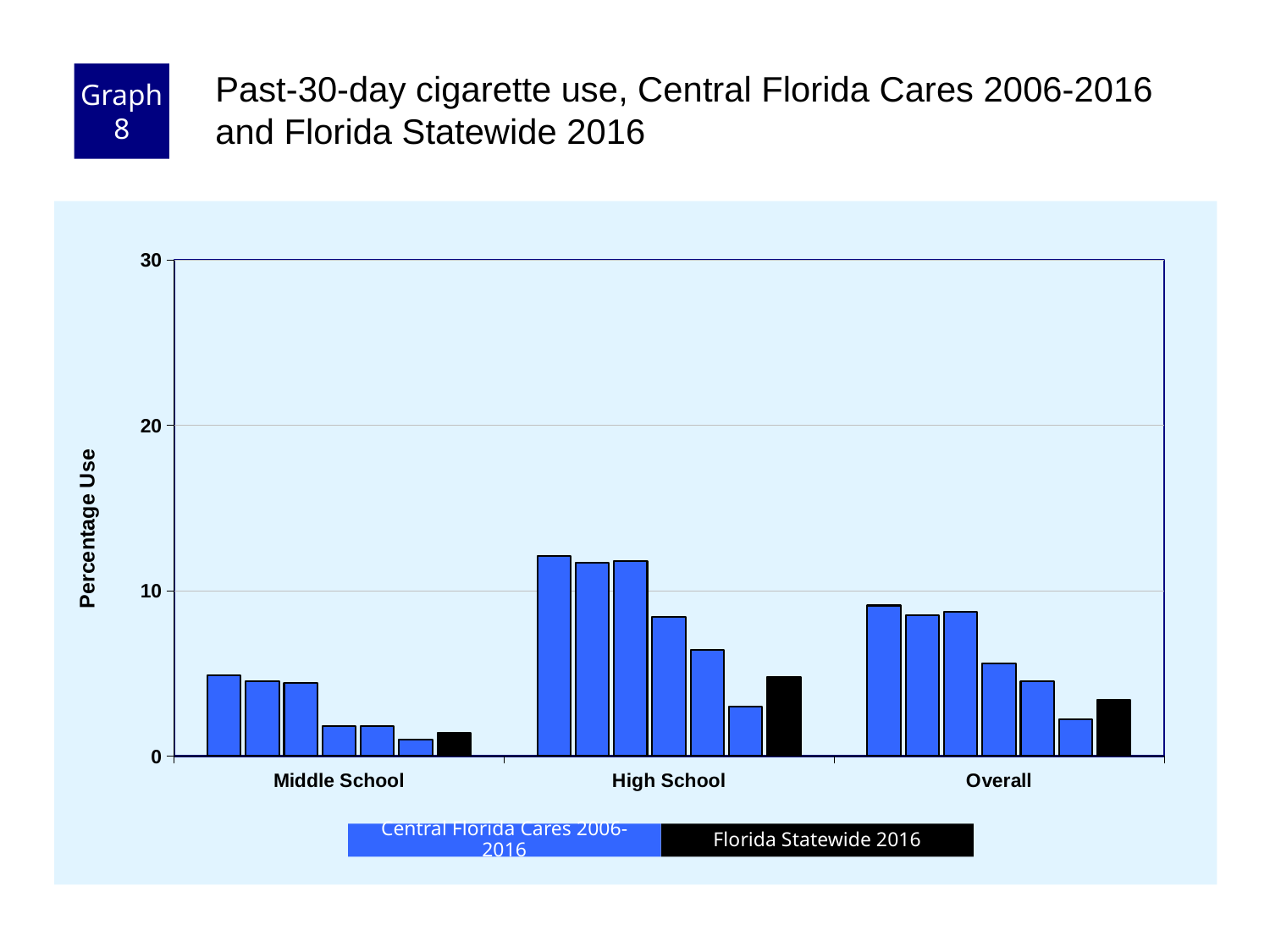
Which is larger, the Florida Statewide 2016 value for High School or for Middle School? High School Which category has the highest bars overall: Middle School, High School, or Overall? High School What colour represents Florida Statewide 2016 in the legend? black Is the Florida Statewide 2016 value for High School greater or less than 10? less Which category has the lowest bars overall? Middle School Is the Florida Statewide 2016 value for Overall greater or less than 10? less What kind of chart is shown on the slide? bar chart What is the label on the y axis? Percentage Use Within each category, do the Central Florida Cares 2006-2016 bars generally rise or fall from left to right? fall How many series does the legend list? 2 How many school-level categories are shown on the x axis? 3 Is the tallest Central Florida Cares bar for High School greater or less than 10? greater